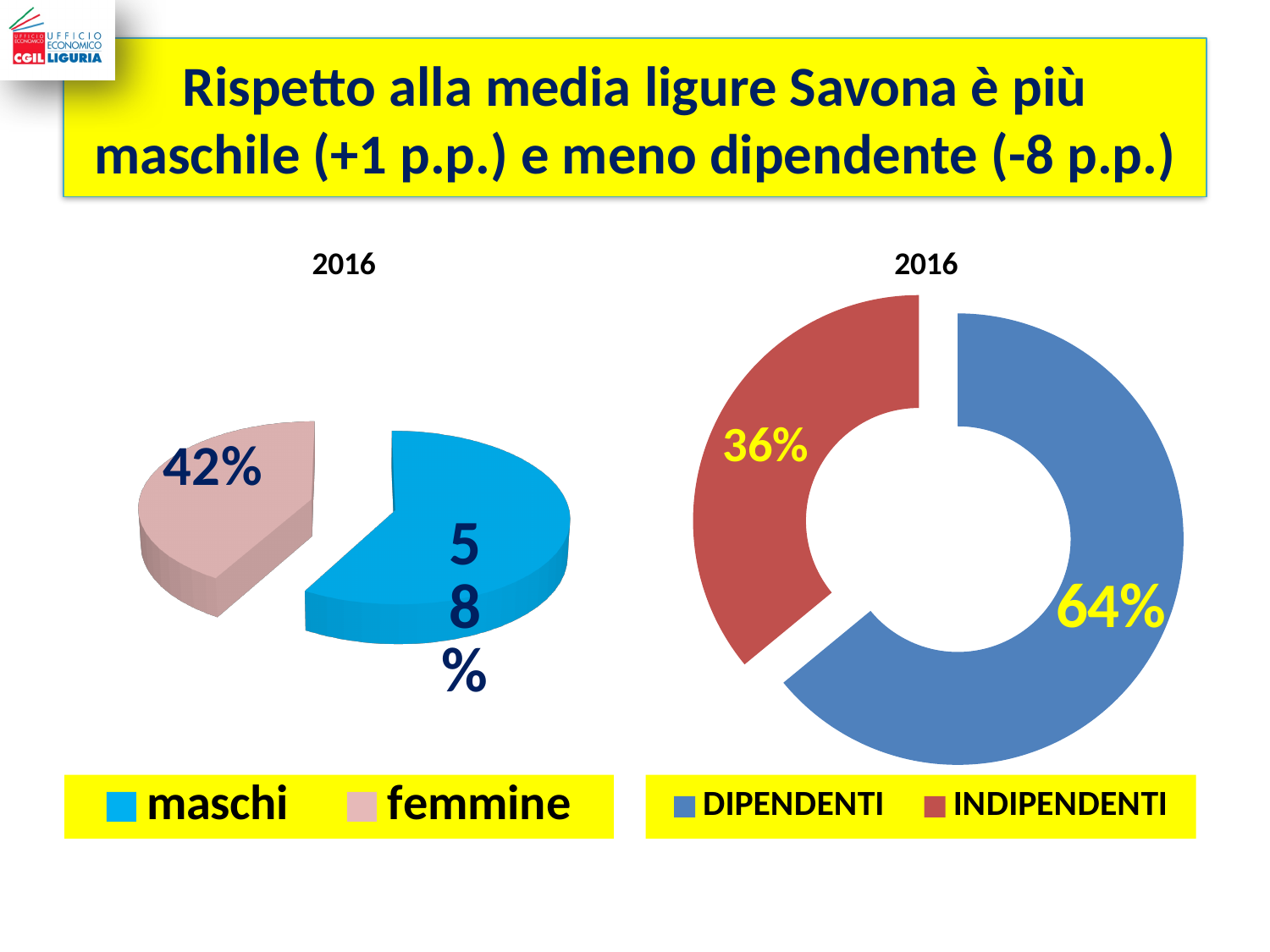
In the left pie chart, which category has the larger share, maschi or femmine? maschi In the right doughnut chart, what is the difference in percentage points between DIPENDENTI and INDIPENDENTI? 28 What is the title shown above each of the two charts? 2016 In the left pie chart (maschi/femmine), what is the share for femmine? 42% In the right doughnut chart, which category has the smallest share? INDIPENDENTI How many series does the legend of the left chart list? 2 In the left pie chart (maschi/femmine), what is the share for maschi? 58% In the right doughnut chart (DIPENDENTI/INDIPENDENTI), what is the share for INDIPENDENTI? 36% What kind of chart is the left chart (maschi/femmine)? pie chart In the right doughnut chart (DIPENDENTI/INDIPENDENTI), what is the share for DIPENDENTI? 64% In the left pie chart, what is the difference in percentage points between maschi and femmine? 16 How many slices does the right doughnut chart have? 2